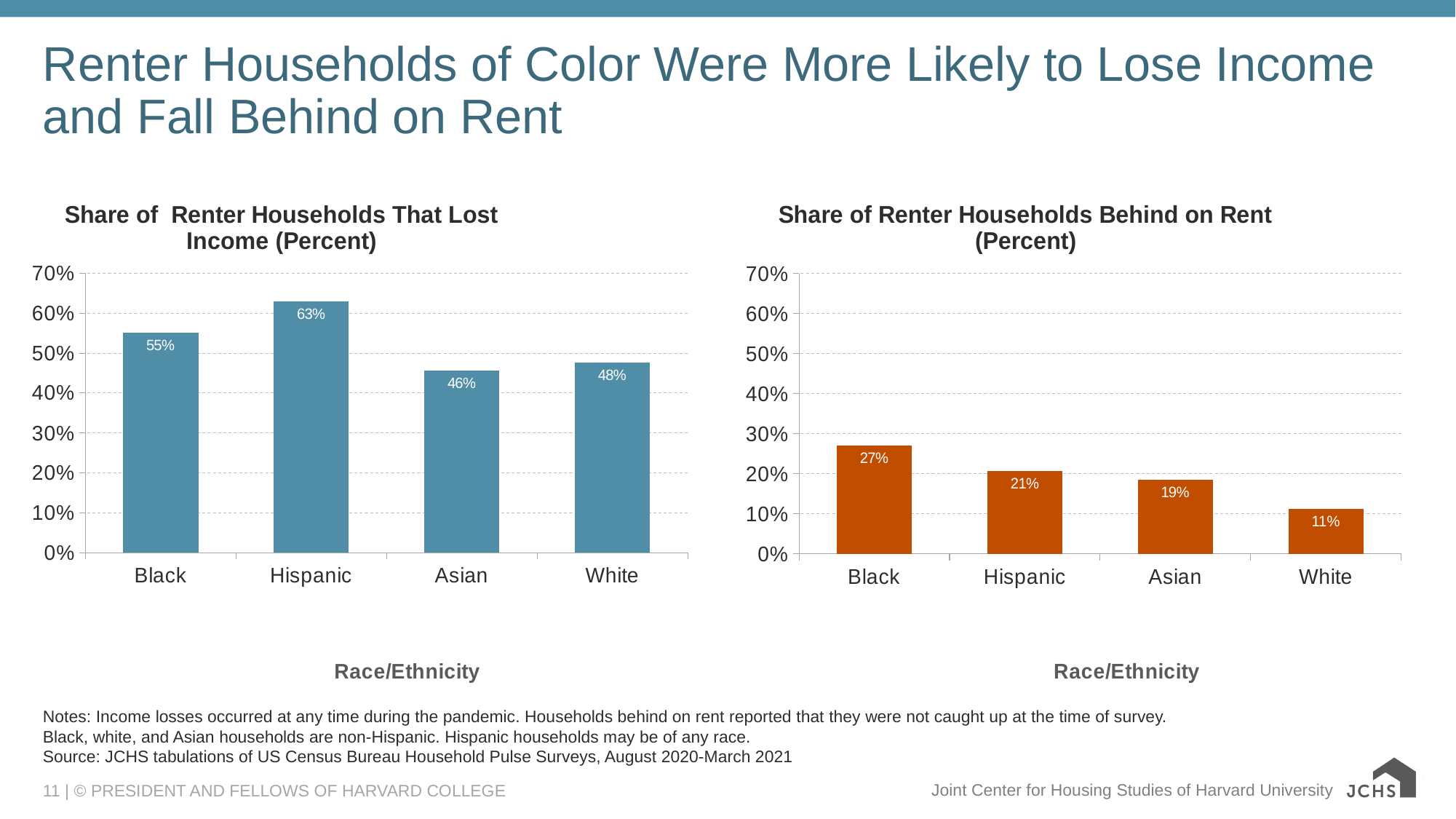
What kind of chart is the 'Share of Renter Households That Lost Income (Percent)' chart? Bar chart In the 'Share of Renter Households That Lost Income (Percent)' chart, what is the value for Hispanic households? 63% In the 'Share of Renter Households Behind on Rent (Percent)' chart, what is the value for White households? 11% In the 'Share of Renter Households Behind on Rent (Percent)' chart, which is larger, the value for Black or Hispanic households? Black In the 'Share of Renter Households Behind on Rent (Percent)' chart, which race/ethnicity has the lowest value? White In the 'Share of Renter Households That Lost Income (Percent)' chart, which race/ethnicity has the highest value? Hispanic In the 'Share of Renter Households That Lost Income (Percent)' chart, which race/ethnicity has the lowest value? Asian What is the x-axis title of the 'Share of Renter Households Behind on Rent (Percent)' chart? Race/Ethnicity In the 'Share of Renter Households Behind on Rent (Percent)' chart, what is the difference between the values for Black and White households? 16% In the 'Share of Renter Households That Lost Income (Percent)' chart, what is the difference between the values for Hispanic and Asian households? 17% How many race/ethnicity categories are shown in the 'Share of Renter Households Behind on Rent (Percent)' chart? 4 In the 'Share of Renter Households That Lost Income (Percent)' chart, is the value for Black households greater or less than 50%? greater